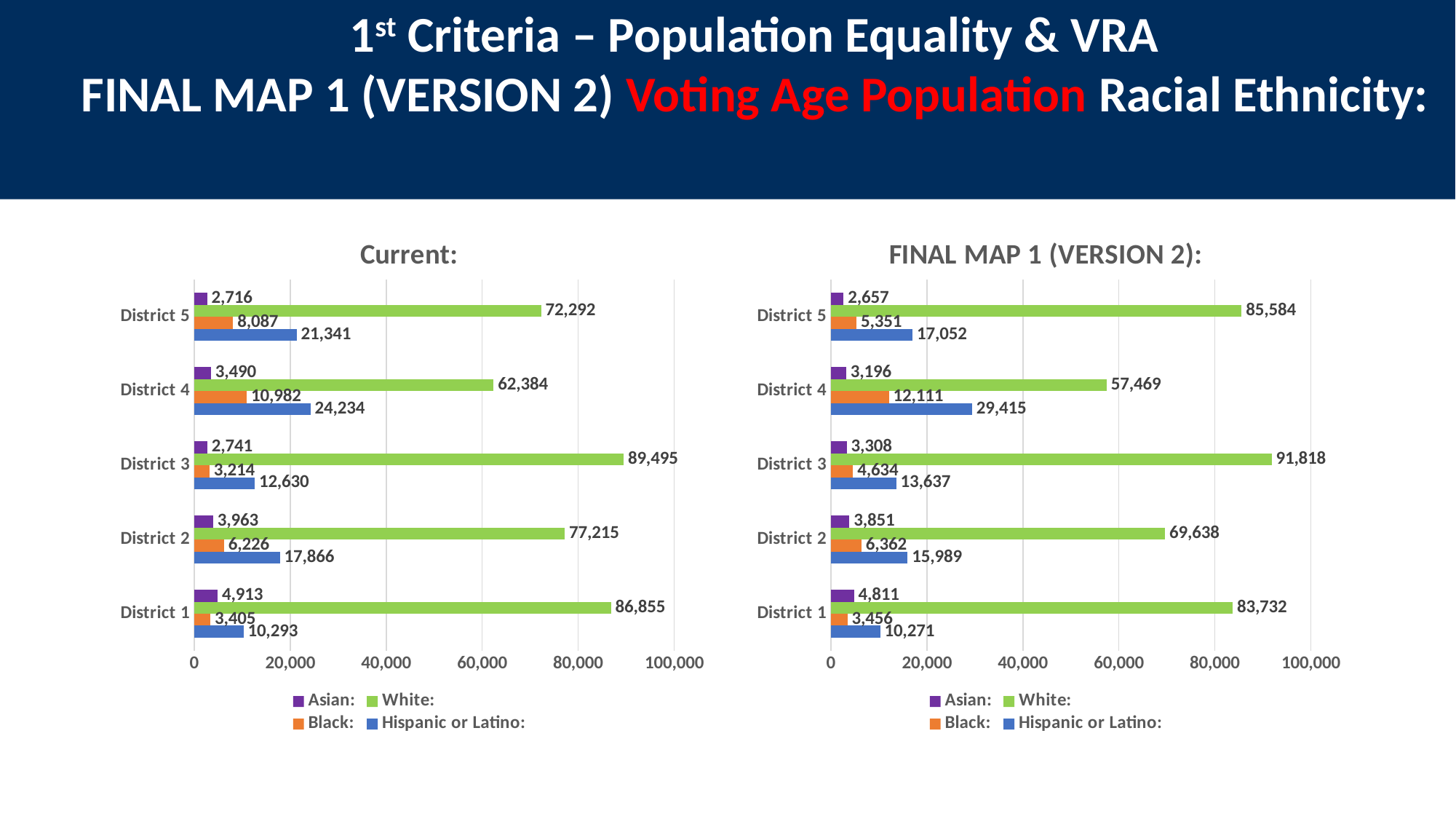
In the "Current:" chart, what is the White voting age population for District 3? 89,495 In the "Current:" chart, which district has the lowest Black value? District 3 In the "FINAL MAP 1 (VERSION 2):" chart, what is the Asian value for District 1? 4,811 In the "FINAL MAP 1 (VERSION 2):" chart, which district has the highest White value? District 3 What kind of chart is the "Current:" chart? bar chart In the "Current:" chart, what is the difference between the Hispanic or Latino values for District 4 and District 1? 13,941 In the "Current:" chart, which colour represents the White series? green How many series does the legend of the "FINAL MAP 1 (VERSION 2):" chart list? 4 In the "FINAL MAP 1 (VERSION 2):" chart, which is larger: the Black value for District 4 or the Black value for District 5? District 4 In the "Current:" chart, is the White value for District 5 greater or less than 80,000? less In the "FINAL MAP 1 (VERSION 2):" chart, what is the Hispanic or Latino value for District 4? 29,415 How many districts are shown in the "Current:" chart? 5